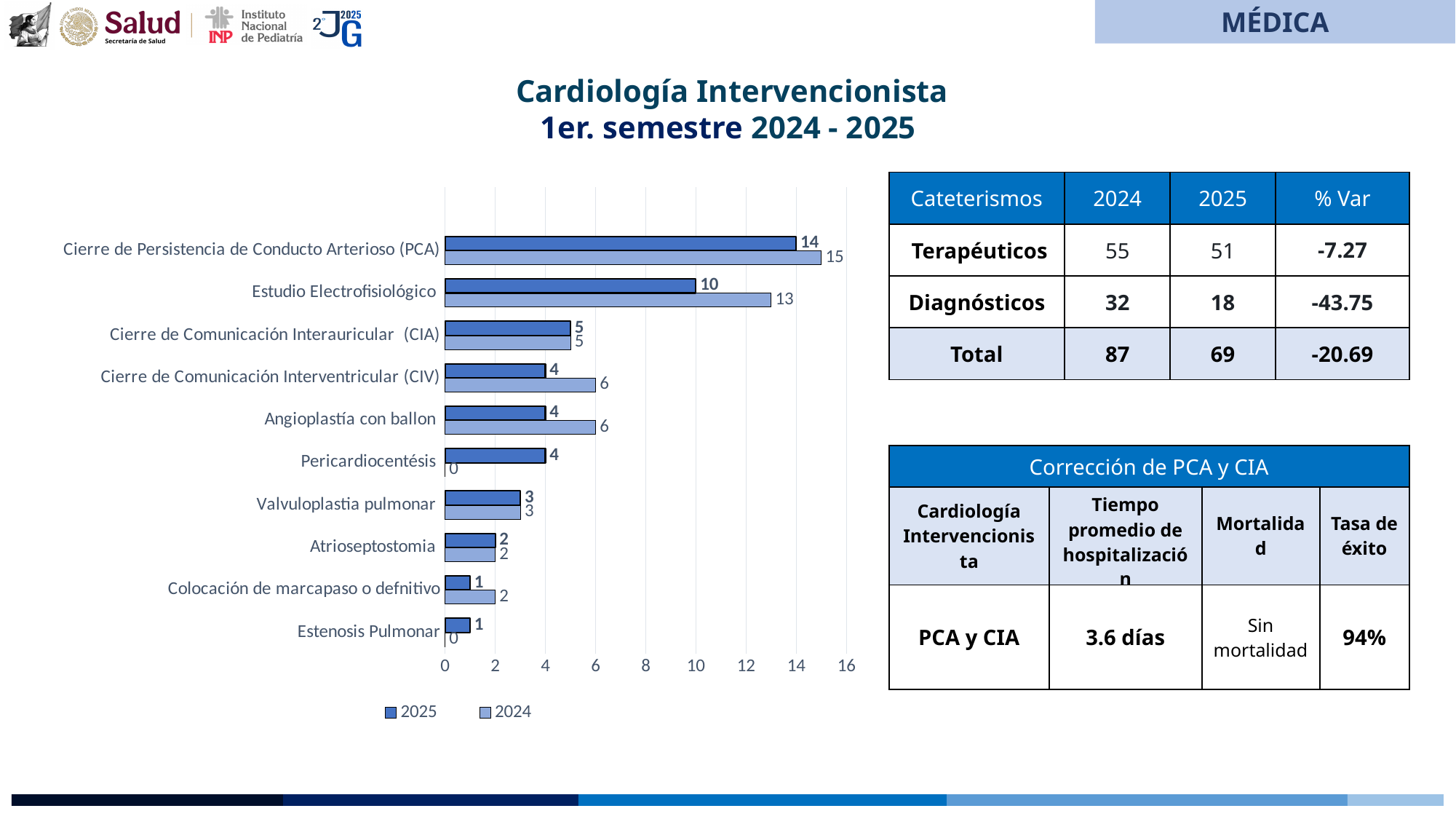
What is the difference between the 2024 and 2025 values for Estudio Electrofisiológico? 3 What is the 2025 value for Colocación de marcapaso o defnitivo? 1 Which series is shown in the darker blue colour in the chart? 2025 What is the difference between the 2024 and 2025 values for Cierre de Persistencia de Conducto Arterioso (PCA)? 1 How many series does the legend list? 2 Which category has the highest 2024 value? Cierre de Persistencia de Conducto Arterioso (PCA) What is the 2025 value for Cierre de Persistencia de Conducto Arterioso (PCA)? 14 What is the 2024 value for Pericardiocentésis? 0 Which is larger for Cierre de Comunicación Interventricular (CIV): the 2024 value or the 2025 value? 2024 How many categories are shown in the bar chart? 10 What is the 2024 value for Estudio Electrofisiológico? 13 What kind of chart is shown on the slide? Bar chart